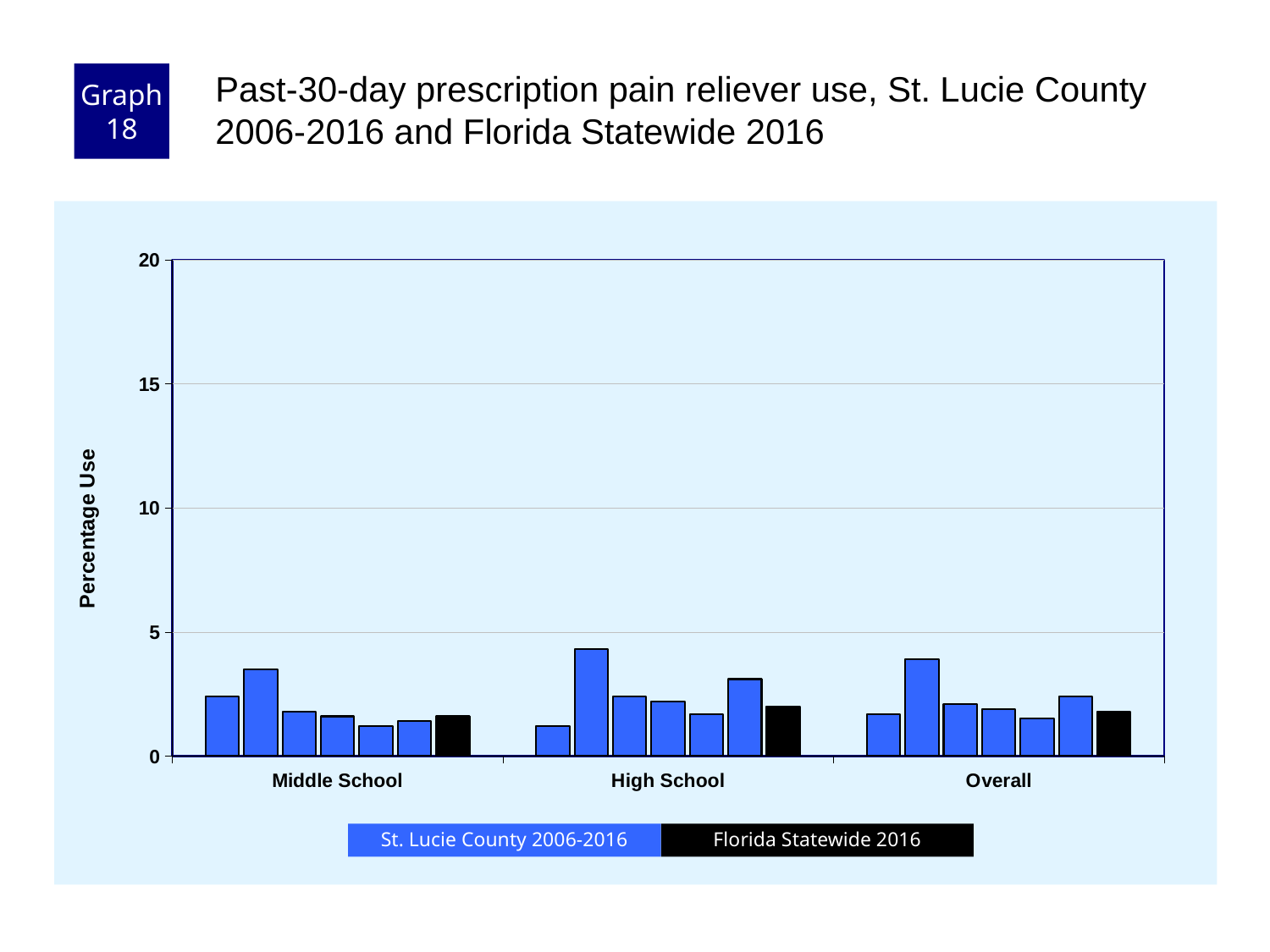
Is the tallest St. Lucie County 2006-2016 bar for Middle School greater or less than 5? less Is the Florida Statewide 2016 value for Middle School greater or less than 5? less Is the Florida Statewide 2016 value for High School greater or less than 5? less What kind of chart is shown on the slide? bar chart How many series does the legend list? 2 How many categories are shown on the x axis? 3 Which colour represents Florida Statewide 2016 in the legend? black What is the label of the y axis? Percentage Use What is the highest value shown on the y axis? 20 How many bars are plotted in the High School group? 7